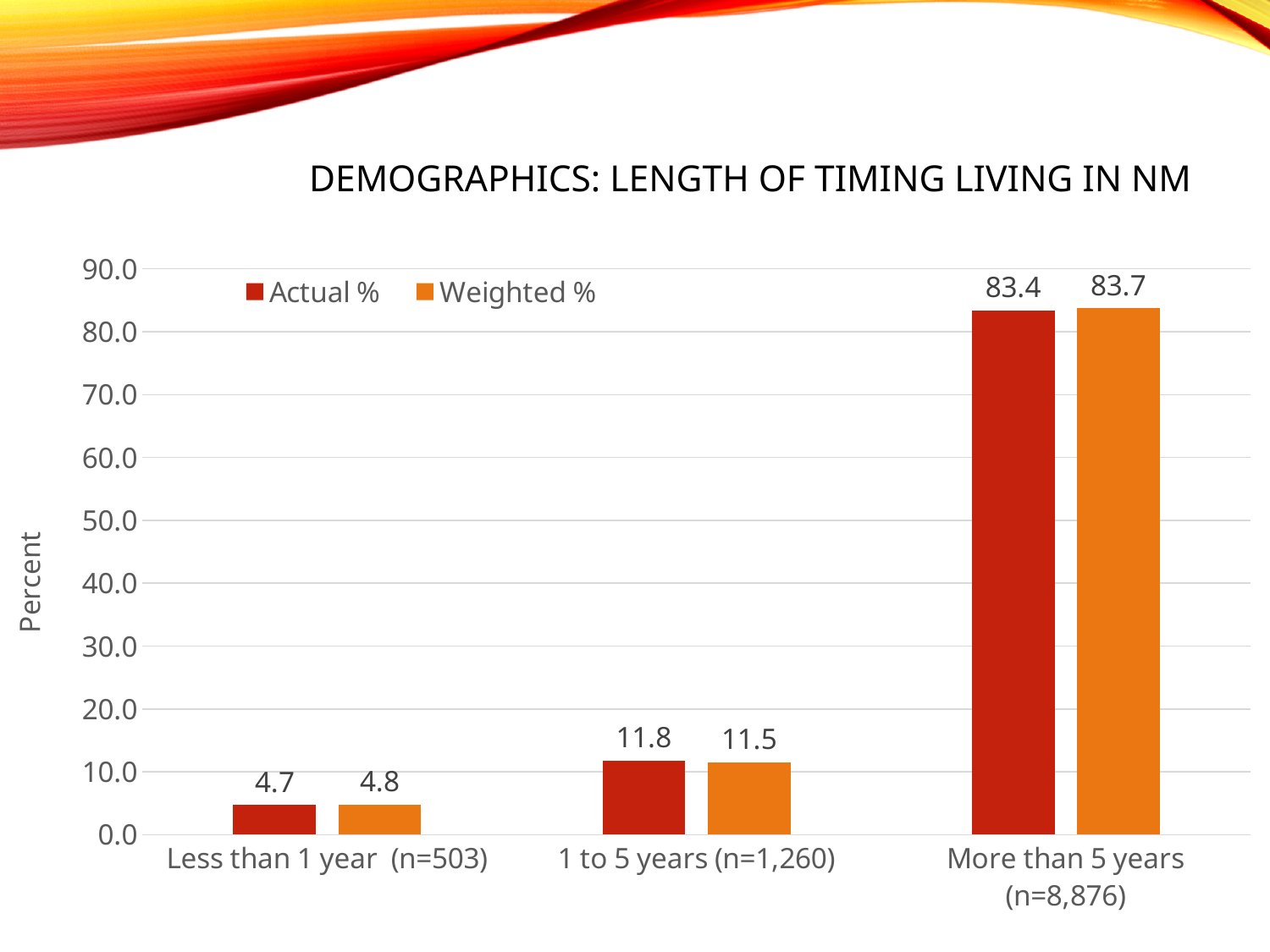
Which is larger: the Actual % for '1 to 5 years (n=1,260)' or the Actual % for 'Less than 1 year (n=503)'? 1 to 5 years (n=1,260) What is the Weighted % value for 'More than 5 years (n=8,876)'? 83.7 Which category has the lowest Weighted % value? Less than 1 year (n=503) Is the Weighted % value for 'More than 5 years (n=8,876)' greater or less than 80.0? greater What kind of chart is shown on the slide? Bar chart How many series does the legend list? 2 Which category has the highest Actual % value? More than 5 years (n=8,876) What is the difference between the Actual % values for 'More than 5 years (n=8,876)' and '1 to 5 years (n=1,260)'? 71.6 What is the Weighted % value for '1 to 5 years (n=1,260)'? 11.5 How many categories are shown on the x axis? 3 What is the Actual % value for 'Less than 1 year (n=503)'? 4.7 What is the difference between the Actual % and Weighted % values for '1 to 5 years (n=1,260)'? 0.3